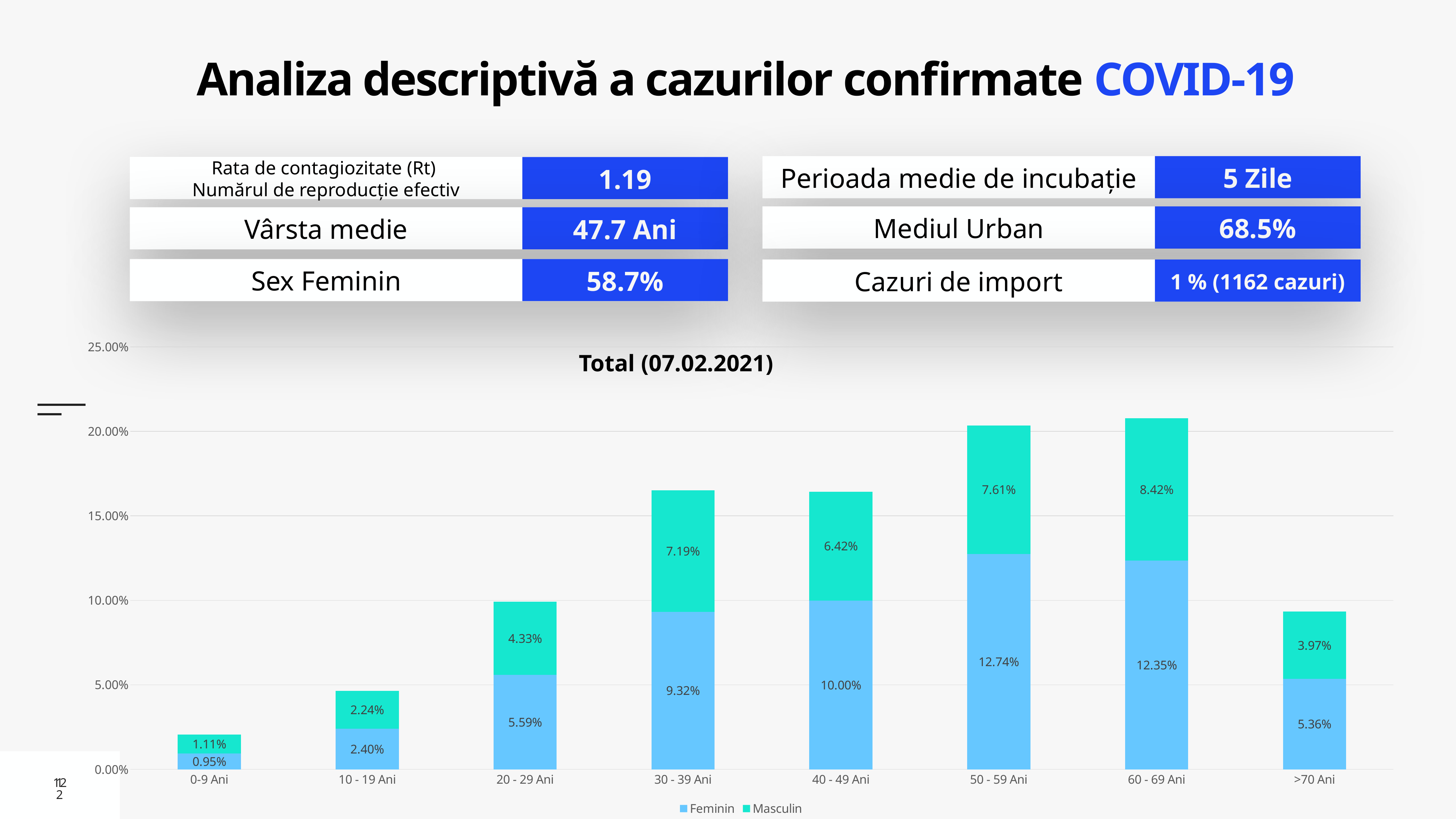
Which is larger: the Feminin value for 30 - 39 Ani or the Feminin value for 40 - 49 Ani? 40 - 49 Ani How many series does the legend list? 2 What is the Feminin value for the 40 - 49 Ani age group? 10.00% How many age groups are shown on the x axis? 8 What is the difference between the Feminin and Masculin values for the 50 - 59 Ani age group? 5.13% Which age group has the lowest Masculin value? 0-9 Ani What is the Masculin value for the 60 - 69 Ani age group? 8.42% What is the Masculin value for the >70 Ani age group? 3.97% Which age group has the highest Feminin value? 50 - 59 Ani Is the total stacked value for the 60 - 69 Ani bar greater or less than 20.00%? greater What is the total of the stacked bar for the 0-9 Ani age group? 2.06% What kind of chart is shown on the slide? Stacked bar chart